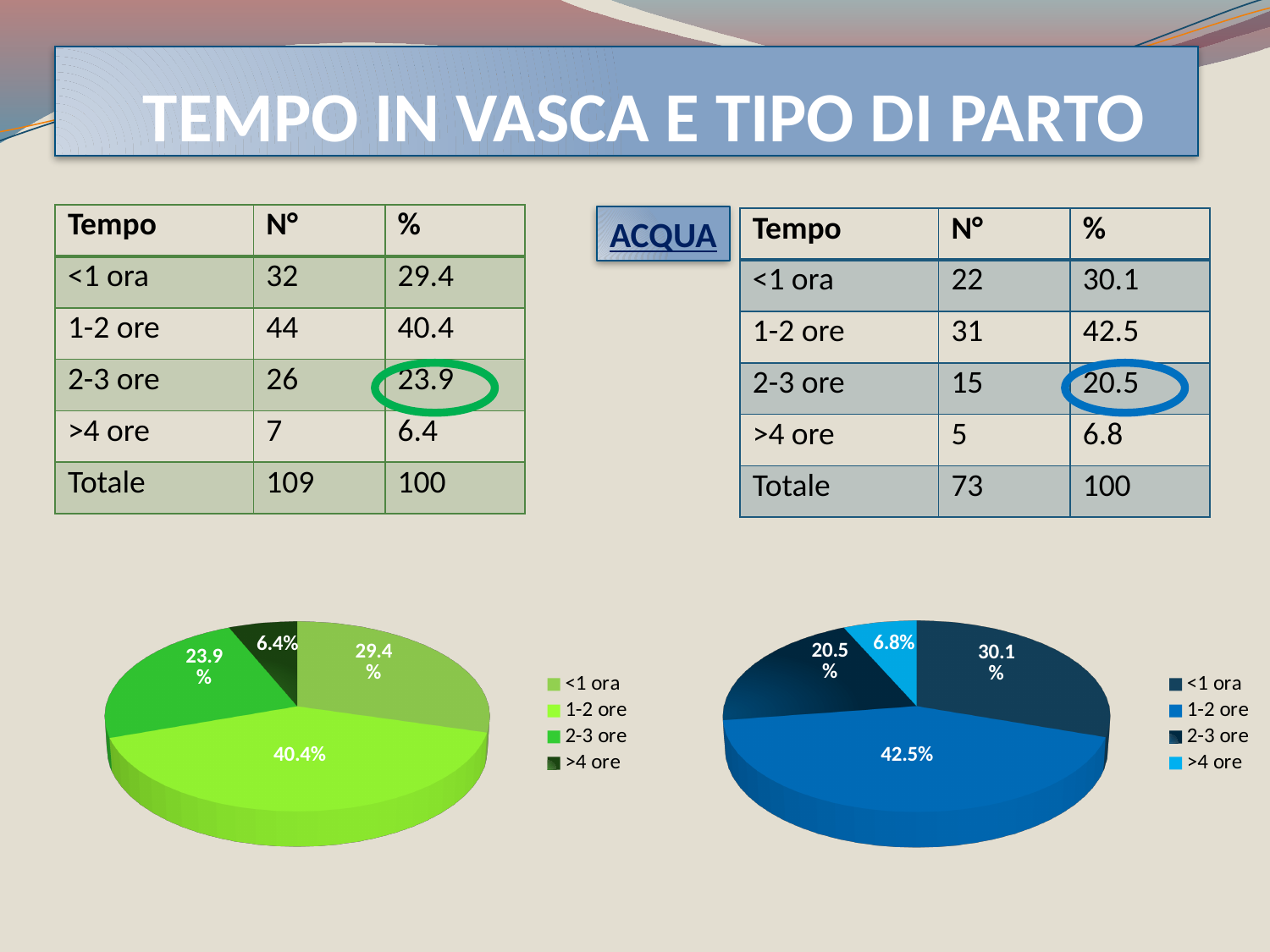
In the left (green) pie chart, what is the share for 1-2 ore? 40.4% In the right (blue) pie chart, what is the share for 1-2 ore? 42.5% In the right (blue) pie chart, which category has the smallest slice? >4 ore In the right (blue) pie chart, what is the difference between the shares for 1-2 ore and >4 ore? 35.7% In the right (blue) pie chart, what is the share for 2-3 ore? 20.5% How many slices does the left (green) pie chart have? 4 In the right (blue) pie chart, which is larger: the share for <1 ora or the share for 2-3 ore? <1 ora In the left (green) pie chart, what is the share for >4 ore? 6.4% In the left (green) pie chart, what is the difference between the shares for 1-2 ore and <1 ora? 11.0% What type of chart is the right (blue) chart? Pie chart In the left (green) pie chart, which category has the largest slice? 1-2 ore How many entries does the legend of the right (blue) pie chart list? 4